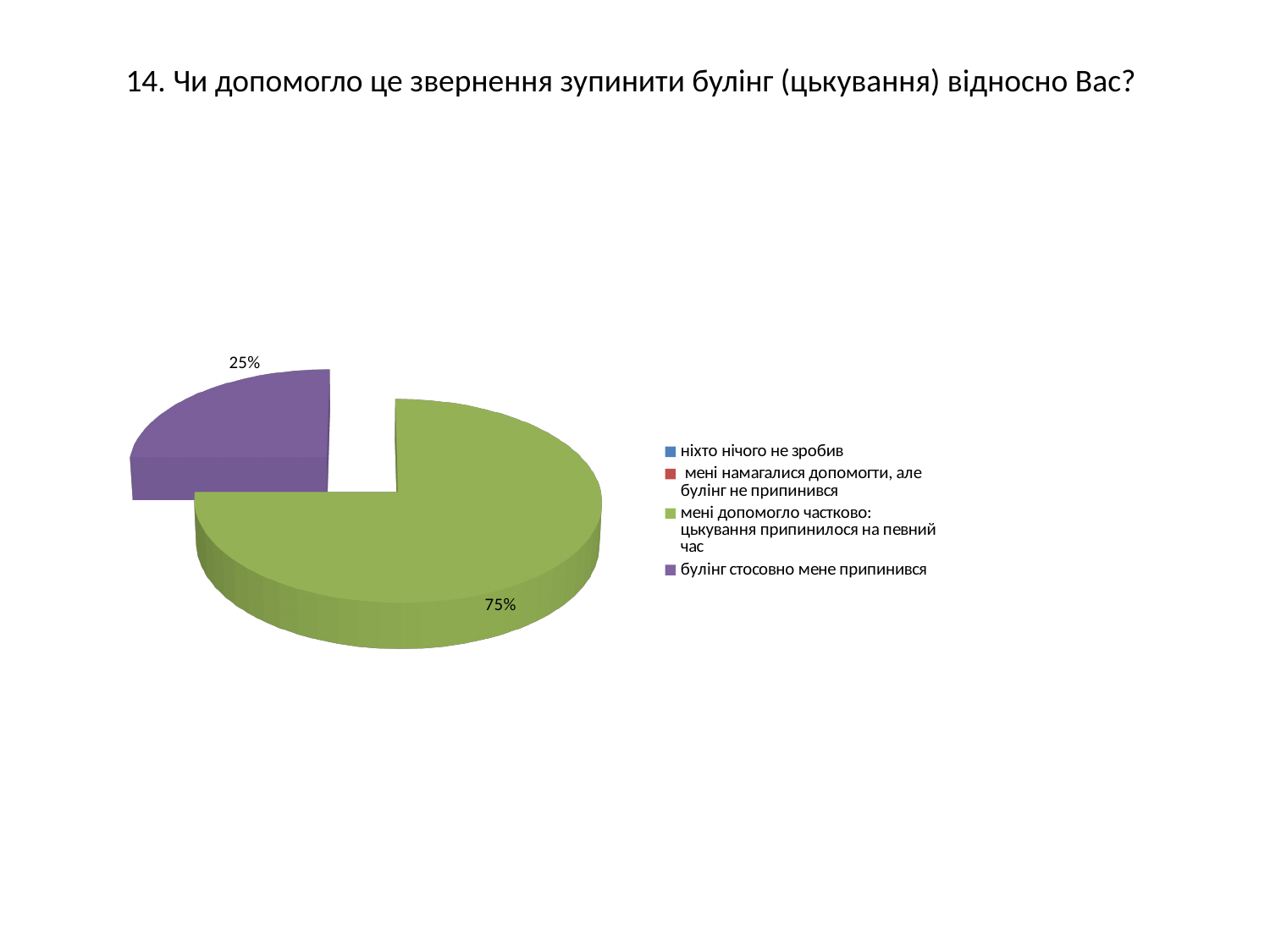
What colour is the slice labelled 75%? green How many entries does the legend list? 4 What share of the pie does the slice "булінг стосовно мене припинився" take? 25% Which category has the largest slice of the pie? мені допомогло частково: цькування припинилося на певний час What kind of chart is shown on the slide? pie chart What is the title of the slide above the chart? 14. Чи допомогло це звернення зупинити булінг (цькування) відносно Вас? What is the difference in percentage points between the 75% slice and the 25% slice? 50 percentage points Which of the two visible slices is smaller, "булінг стосовно мене припинився" or "мені допомогло частково: цькування припинилося на певний час"? булінг стосовно мене припинився How many slices with a visible data label are shown in the pie? 2 What share of the pie does the slice "мені допомогло частково: цькування припинилося на певний час" take? 75% Is the share for "булінг стосовно мене припинився" greater or less than 50%? less